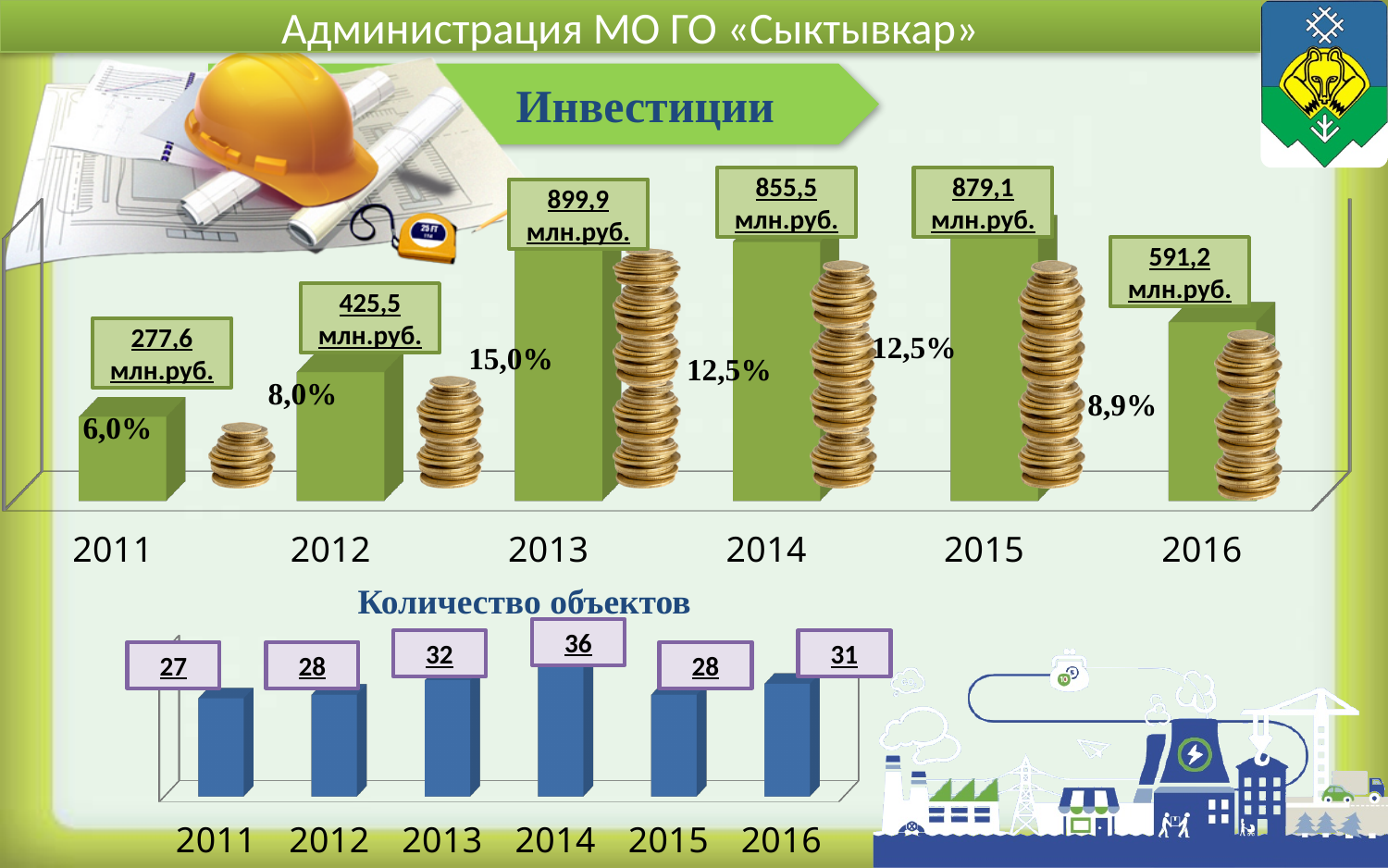
In the "Количество объектов" chart, which year has the lowest value? 2011 In the "Инвестиции" chart, which year has the highest value? 2013 In the "Инвестиции" chart, what is the value for 2013? 899,9 млн.руб. In the "Инвестиции" chart, what is the value for 2016? 591,2 млн.руб. In the "Количество объектов" chart, what is the difference between the values for 2014 and 2011? 9 In the "Количество объектов" chart, what is the value for 2014? 36 In the "Инвестиции" chart, what is the difference between the values for 2015 and 2014? 23,6 млн.руб. In the "Инвестиции" chart, which year has the lowest value? 2011 In the "Инвестиции" chart, what percentage is shown next to the 2013 bar? 15,0% What kind of chart is the "Количество объектов" chart? Bar chart In the "Количество объектов" chart, which is larger, the value for 2013 or the value for 2016? 2013 In the "Инвестиции" chart, how many years are shown? 6